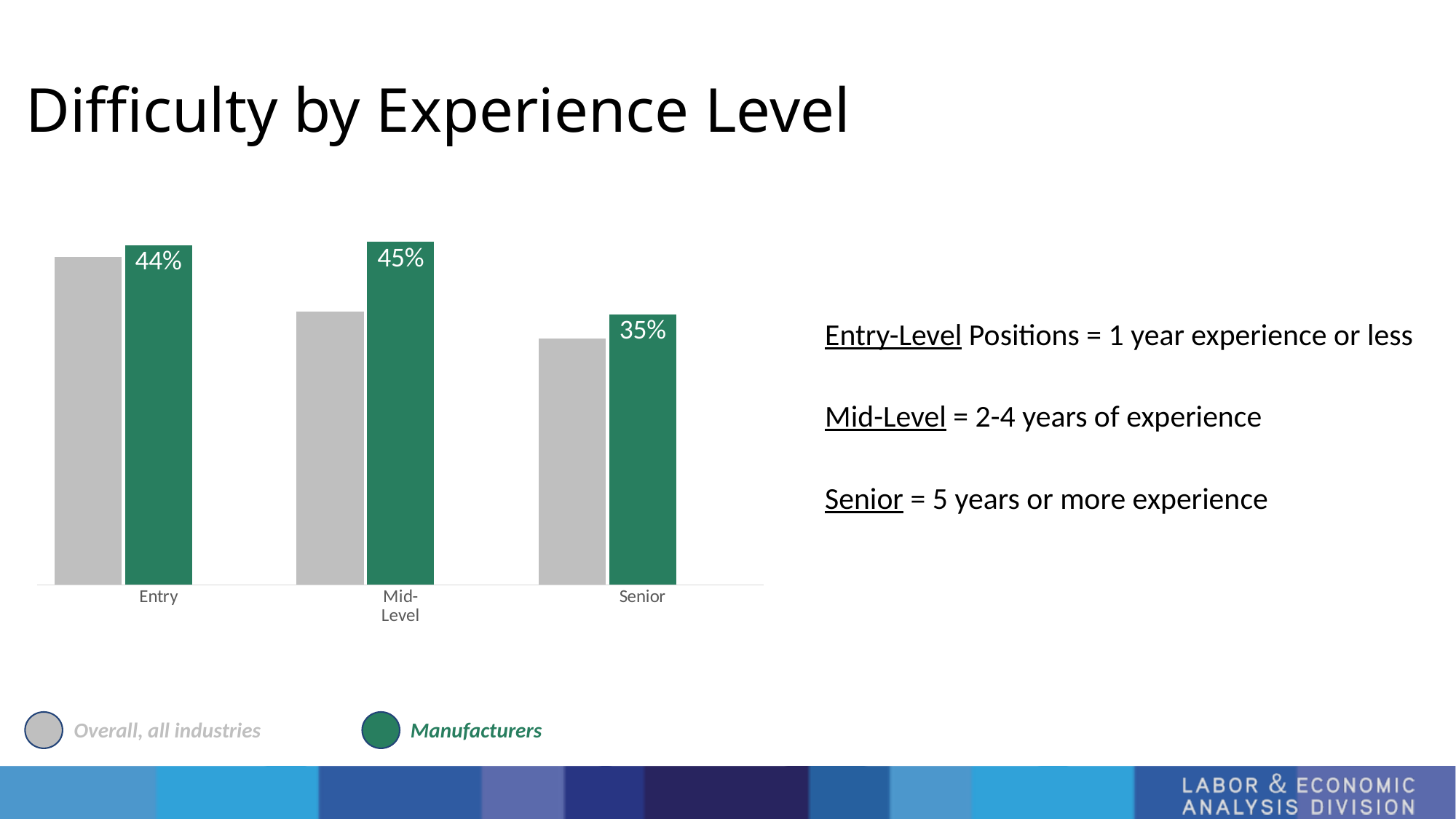
What is the Manufacturers value for Entry level? 44% What is the Manufacturers value for Mid-Level? 45% How many experience level categories are shown on the chart? 3 Which experience level has the highest Manufacturers value? Mid-Level What is the difference between the Manufacturers values for Mid-Level and Senior? 10 percentage points For Senior positions, which is larger: the Overall, all industries bar or the Manufacturers bar? Manufacturers What is the difference between the Manufacturers values for Entry and Senior? 9 percentage points Which experience level has the lowest Manufacturers value? Senior What kind of chart is shown on the slide? Bar chart How many series does the legend list? 2 What is the Manufacturers value for Senior? 35% For Mid-Level positions, which is larger: the Overall, all industries bar or the Manufacturers bar? Manufacturers